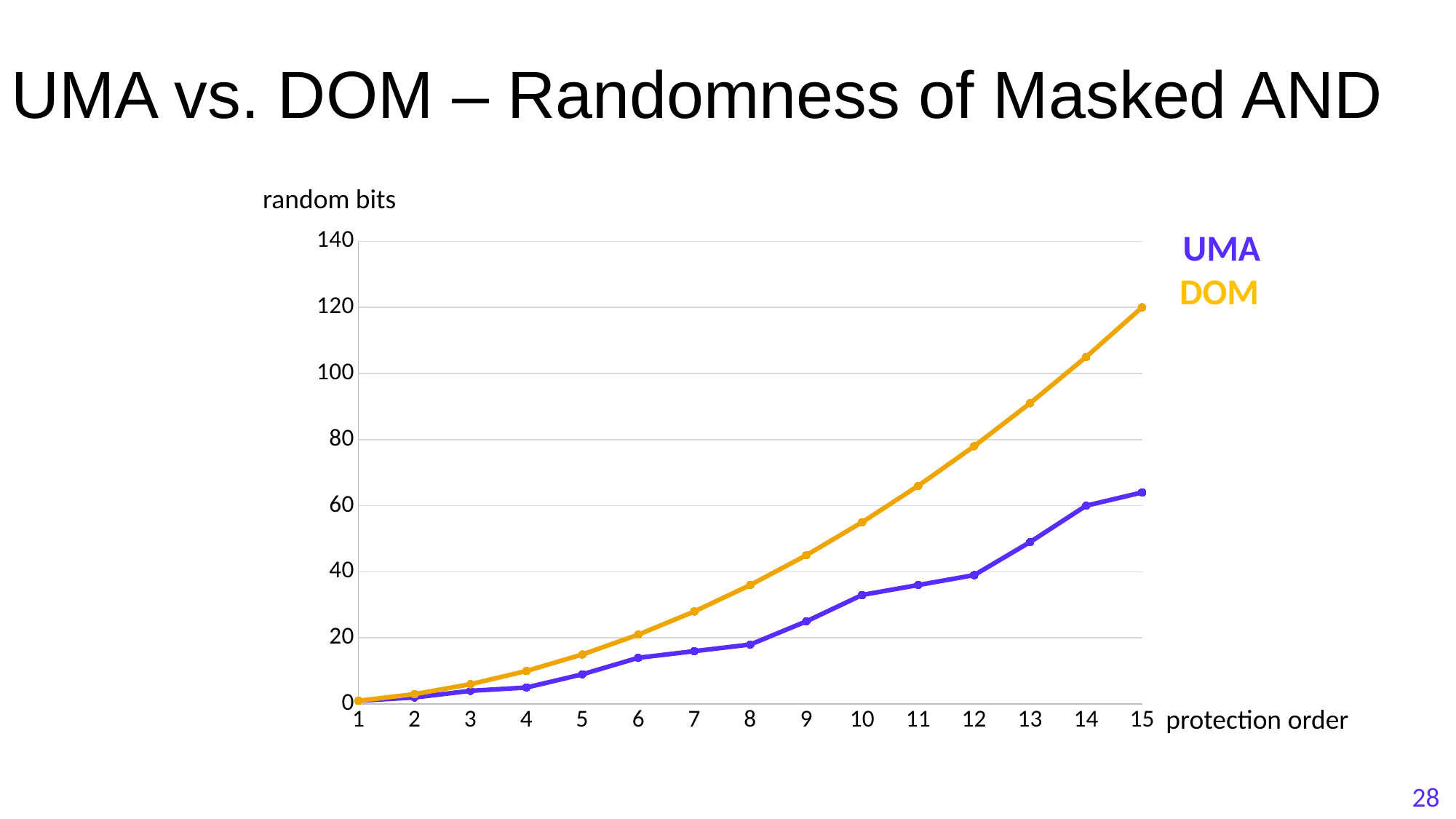
How many protection orders are plotted along the x axis? 15 Is the DOM value at protection order 10 greater or less than 40? greater At protection order 15, which series has the higher value, UMA or DOM? DOM What is the label of the vertical axis? random bits Do the values of the DOM series rise or fall as the protection order increases? rise How many series does the chart show? 2 Is the UMA value at protection order 5 greater or less than 20? less What kind of chart is shown on the slide? line chart Is the UMA value at protection order 15 greater or less than 80? less Which colour is used for the DOM series? orange